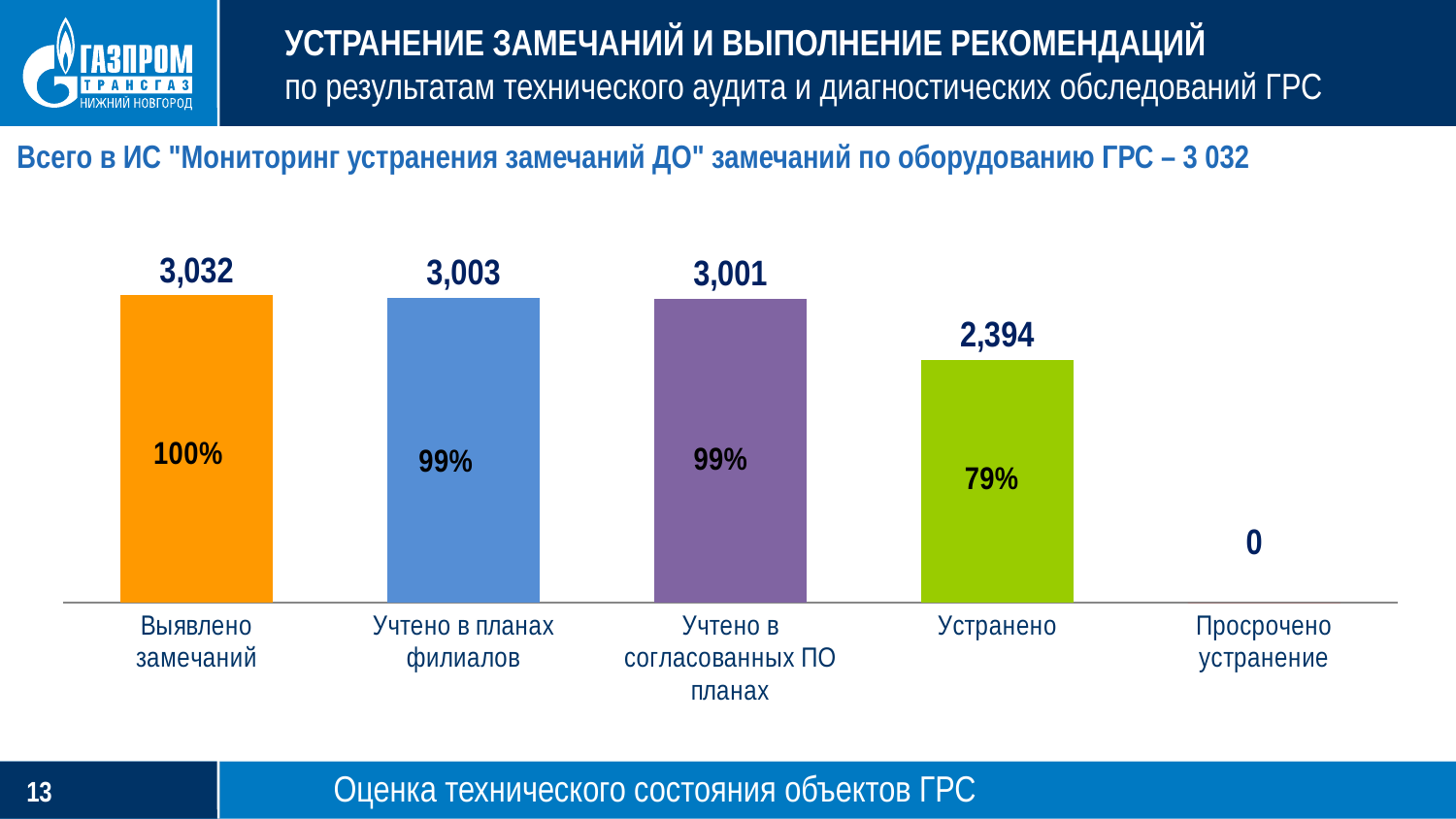
Which category has the lowest value? Просрочено устранение What is the value for "Устранено"? 2,394 How many categories are shown on the x axis? 5 What is the difference between "Учтено в планах филиалов" and "Учтено в согласованных ПО планах"? 2 What kind of chart is shown on the slide? bar chart What is the value for "Учтено в согласованных ПО планах"? 3,001 What percentage is shown on the "Устранено" bar? 79% Which category has the highest value? Выявлено замечаний What is the difference between "Выявлено замечаний" and "Устранено"? 638 What is the value for "Просрочено устранение"? 0 What is the value for "Выявлено замечаний"? 3,032 Which is larger, the value for "Учтено в планах филиалов" or the value for "Устранено"? Учтено в планах филиалов